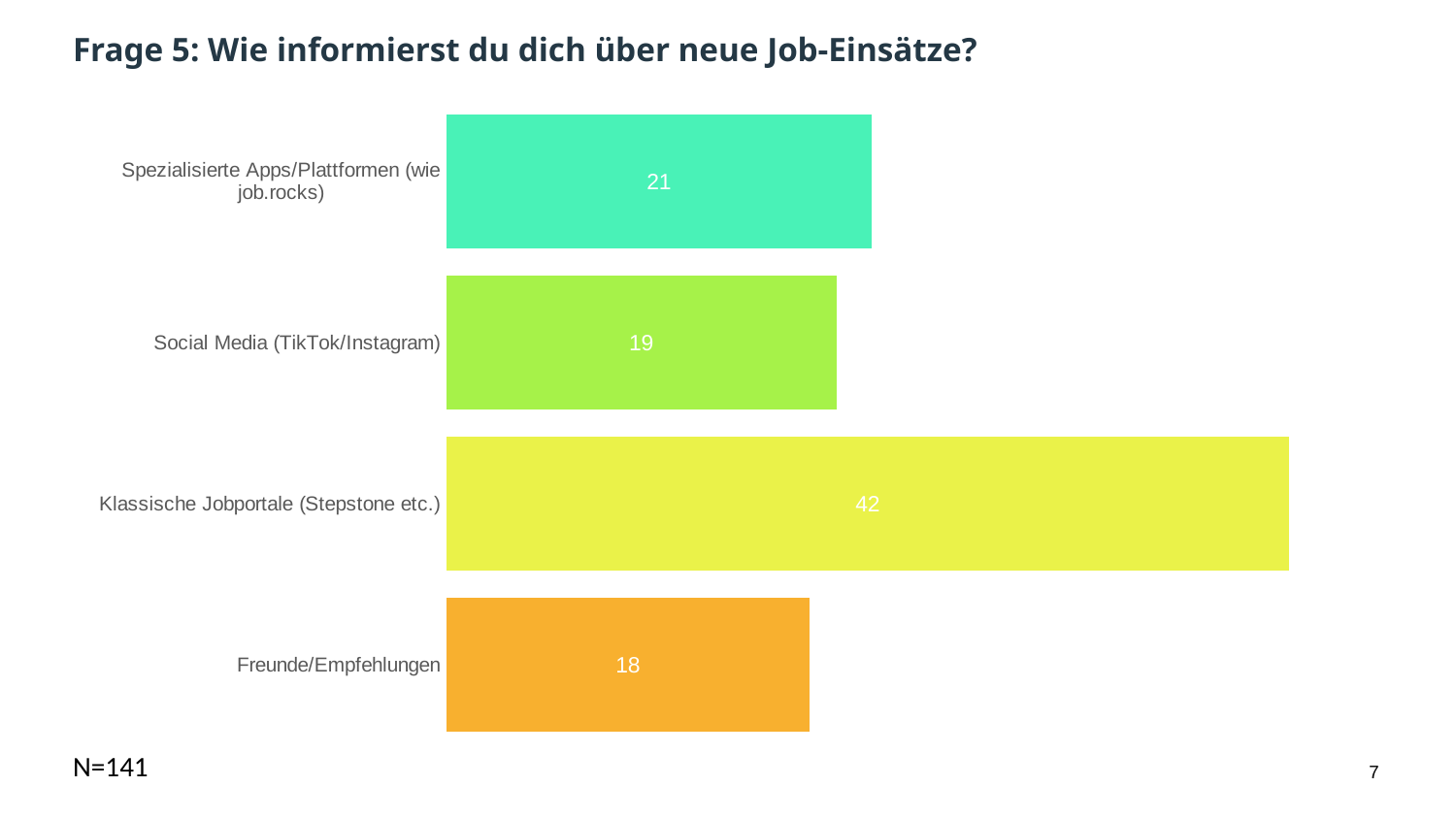
What is the title of the chart? Frage 5: Wie informierst du dich über neue Job-Einsätze? Which is larger: Spezialisierte Apps/Plattformen (wie job.rocks) or Social Media (TikTok/Instagram)? Spezialisierte Apps/Plattformen (wie job.rocks) Which category has the lowest value? Freunde/Empfehlungen Which category has the highest value? Klassische Jobportale (Stepstone etc.) What kind of chart is shown on the slide? Bar chart What is the difference between Klassische Jobportale (Stepstone etc.) and Social Media (TikTok/Instagram)? 23 What is the value for Freunde/Empfehlungen? 18 What is the value for Social Media (TikTok/Instagram)? 19 What is the difference between Spezialisierte Apps/Plattformen (wie job.rocks) and Freunde/Empfehlungen? 3 What is the value for Klassische Jobportale (Stepstone etc.)? 42 How many categories are shown in the chart? 4 What is the value for Spezialisierte Apps/Plattformen (wie job.rocks)? 21